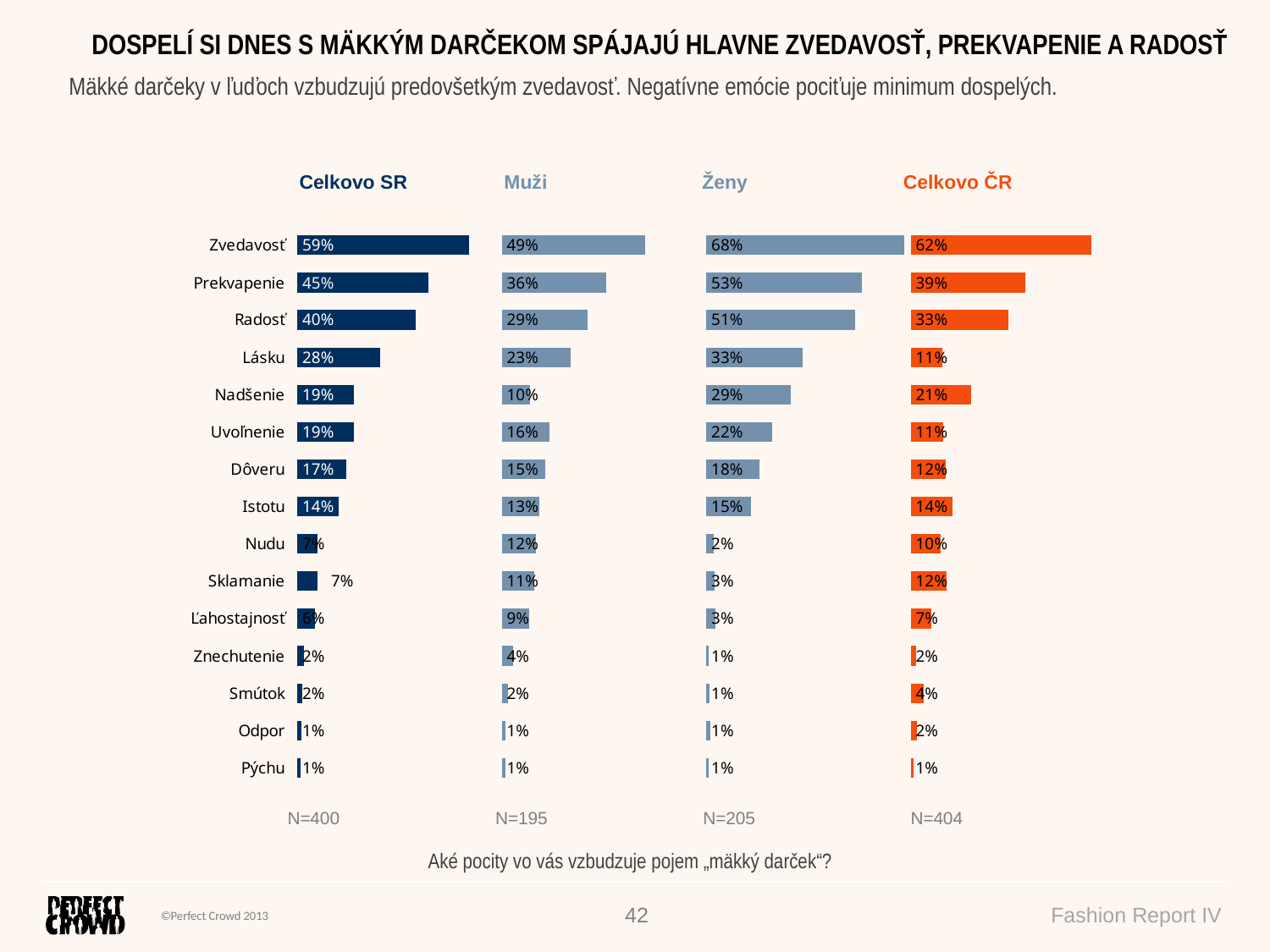
In the Muži chart, which category has the lowest value among Nadšenie, Uvoľnenie and Dôveru? Nadšenie In the Ženy chart, which category has the highest value? Zvedavosť Which chart shows the higher value for Zvedavosť, Muži or Ženy? Ženy In the Celkovo ČR chart, what is the value for Nadšenie? 21% In the Celkovo SR chart, what is the difference between the values for Zvedavosť and Prekvapenie? 14% In the Celkovo ČR chart, which is larger, the value for Lásku or the value for Nadšenie? Nadšenie What type of chart is used for the Celkovo ČR data? Bar chart In the Muži chart, what is the value for Prekvapenie? 36% What sample size (N) is shown under the Ženy chart? N=205 How many categories are listed in the Celkovo SR chart? 15 In the Celkovo SR chart, what is the value for Zvedavosť? 59% In the Ženy chart, what is the value for Radosť? 51%